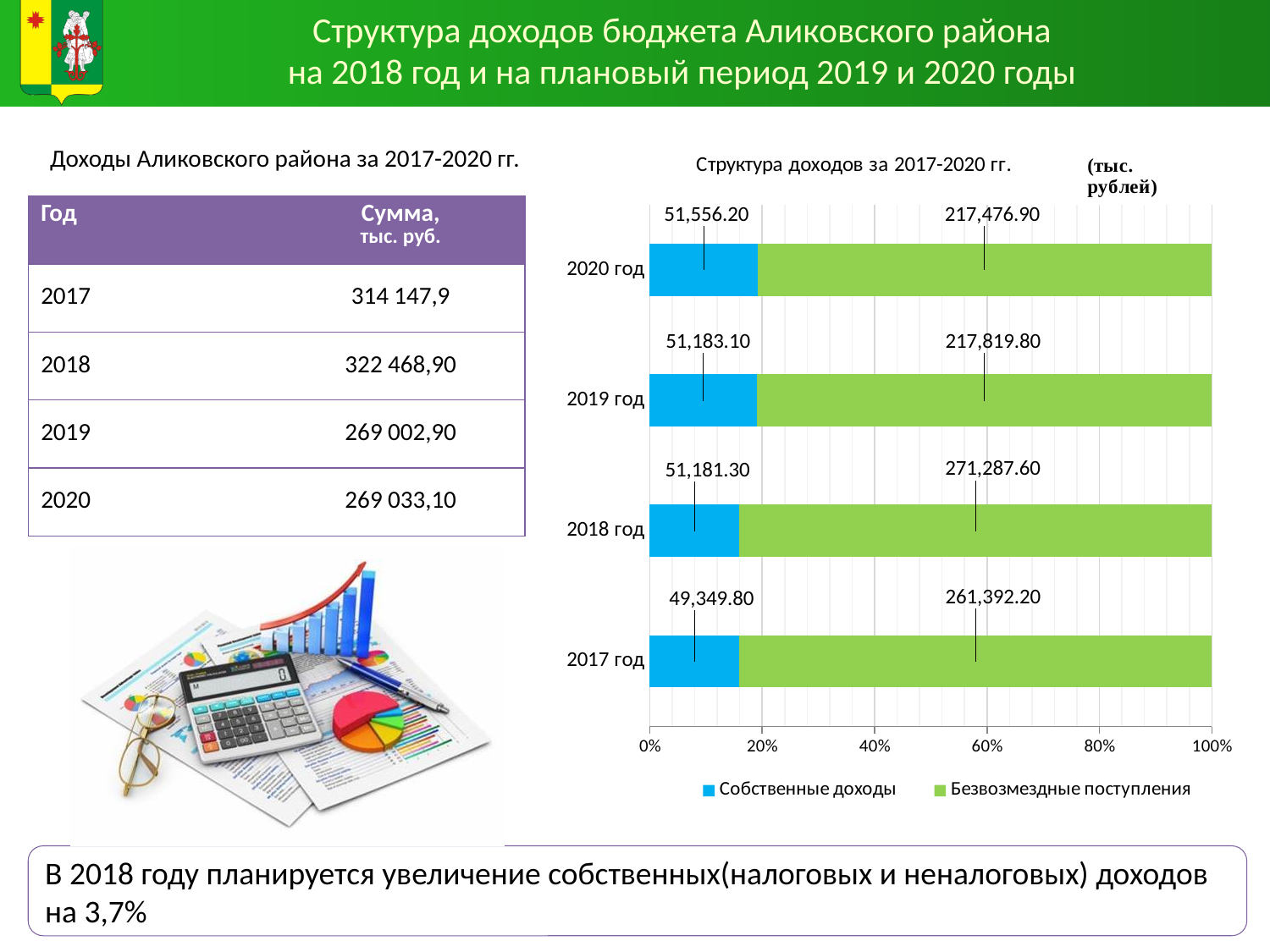
Which year has the highest value of Безвозмездные поступления? 2018 год What is the value of Собственные доходы for 2017 год? 49,349.80 What is the total of Собственные доходы and Безвозмездные поступления for 2020 год? 269,033.10 What kind of chart is shown? Stacked bar chart Which is larger: Собственные доходы in 2019 год or in 2020 год? 2020 год What is the difference between Безвозмездные поступления in 2018 год and 2017 год? 9,895.40 What is the value of Собственные доходы for 2020 год? 51,556.20 How many years are shown in the chart? 4 Which year has the lowest value of Собственные доходы? 2017 год What is the value of Безвозмездные поступления for 2018 год? 271,287.60 How many series does the legend list? 2